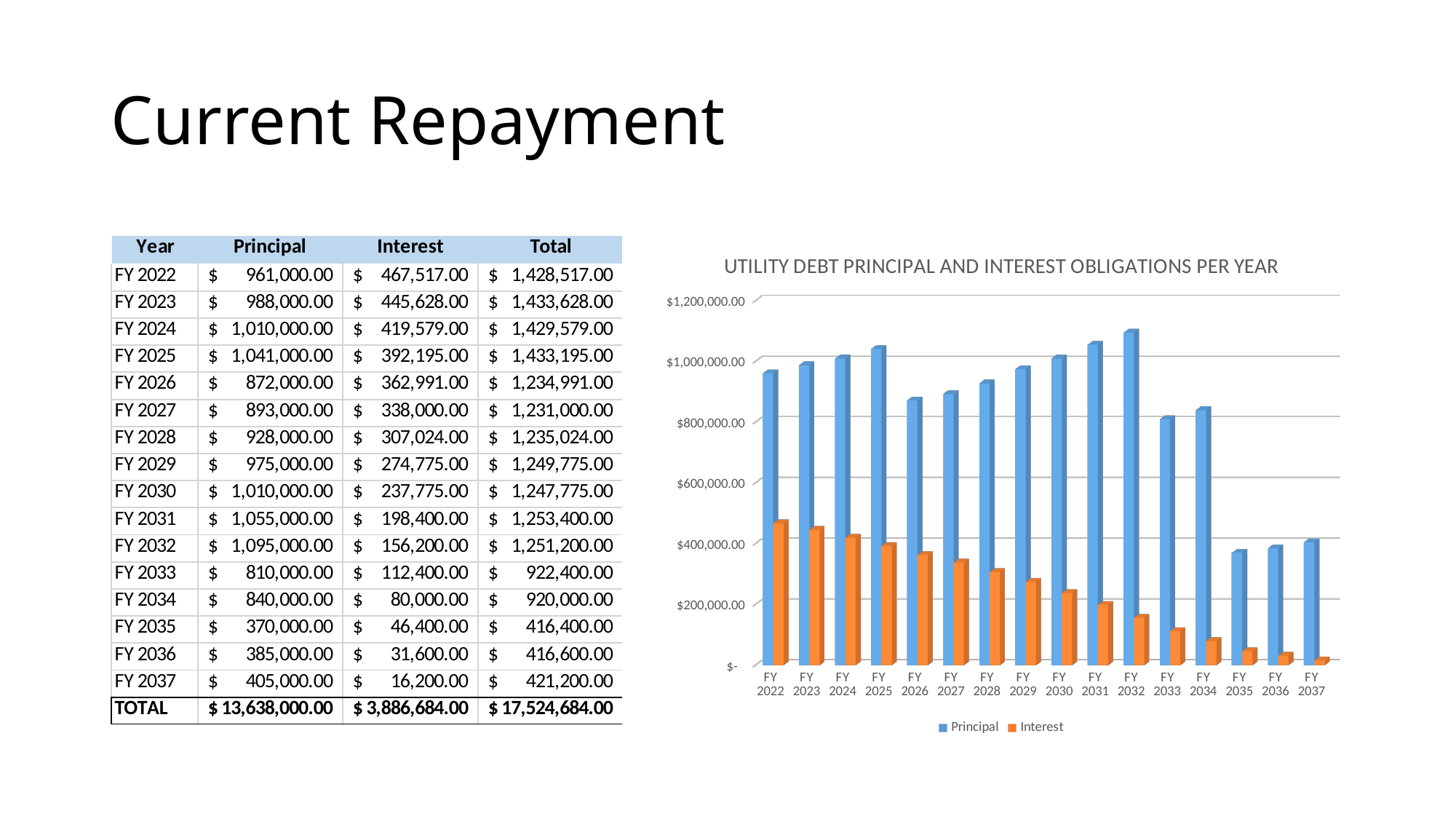
How many series does the chart legend list? 2 What is the title of the chart? UTILITY DEBT PRINCIPAL AND INTEREST OBLIGATIONS PER YEAR What is the Principal value for FY 2022, as printed in the table on the slide? $961,000.00 What kind of chart is shown on the slide? bar chart Is the Interest value for FY 2022 greater or less than $400,000.00? greater Is the Principal value for FY 2033 greater or less than $1,000,000.00? less Do the Interest values rise or fall from FY 2022 to FY 2037? fall In which fiscal year is the Interest bar highest? FY 2022 In which fiscal year is the Interest bar lowest? FY 2037 Which is larger, the Principal for FY 2025 or the Principal for FY 2026? FY 2025 In which fiscal year is the Principal bar highest? FY 2032 How many fiscal years are plotted on the x axis of the chart? 16